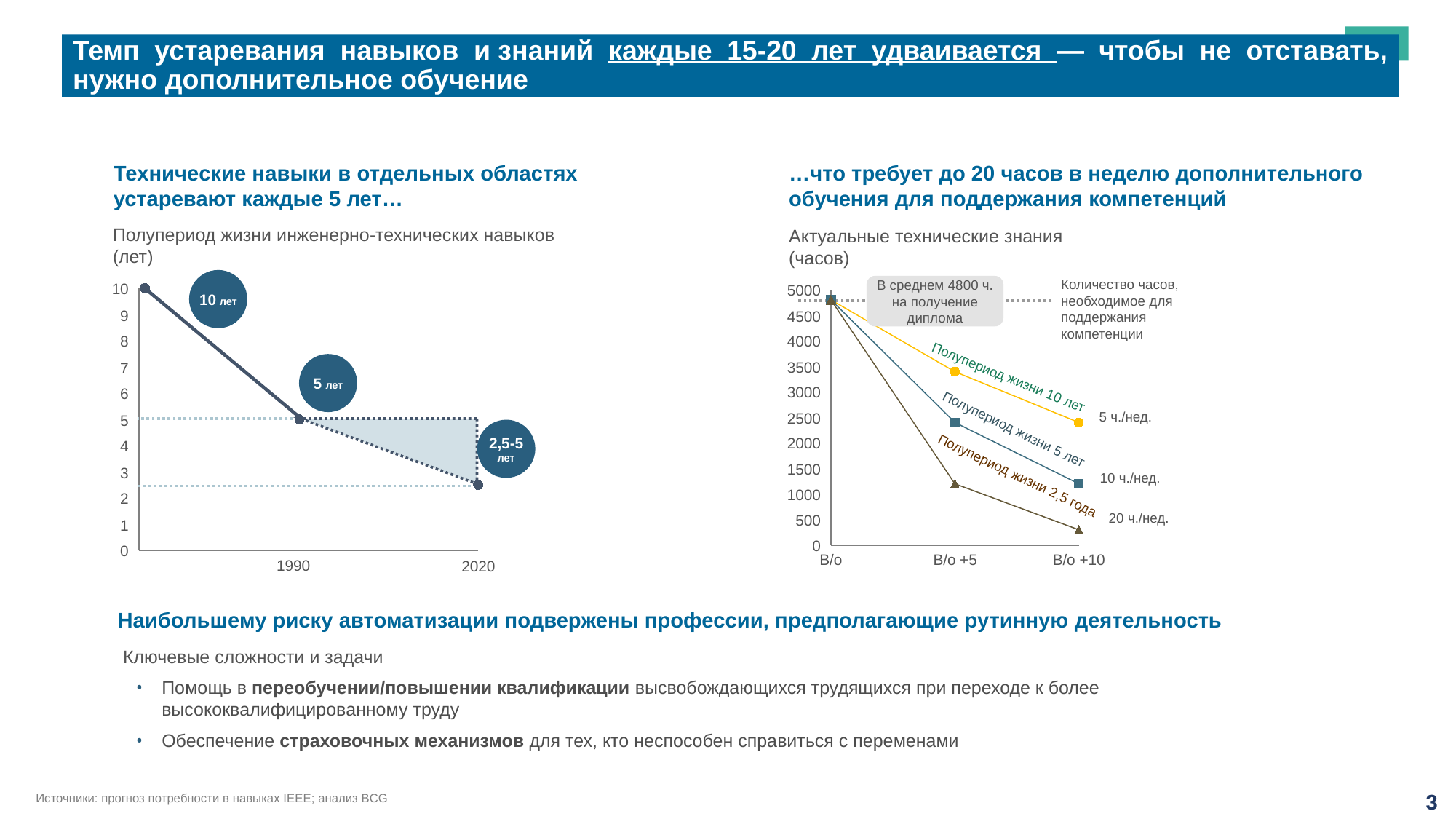
On the right chart (Актуальные технические знания), which series has the highest value at В/о +10? Полупериод жизни 10 лет On the left chart (Полупериод жизни инженерно-технических навыков), do the values rise or fall along the x axis? fall On the left chart (Полупериод жизни инженерно-технических навыков), what is the half-life value labelled at 1990? 5 лет On the left chart (Полупериод жизни инженерно-технических навыков), what kind of chart is it? line chart On the right chart (Актуальные технические знания), how many hours per week are labelled for the 'Полупериод жизни 2,5 года' series? 20 ч./нед. On the right chart (Актуальные технические знания), which series has the lowest value at В/о +10? Полупериод жизни 2,5 года On the right chart (Актуальные технические знания), how many categories are on the x axis? 3 On the right chart (Актуальные технические знания), how many series (half-life lines) are plotted? 3 On the left chart (Полупериод жизни инженерно-технических навыков), what is the half-life value labelled at the starting point of the line? 10 лет On the right chart (Актуальные технические знания), what is the average number of hours to obtain a diploma shown at the starting point? 4800 ч. On the left chart (Полупериод жизни инженерно-технических навыков), what is the half-life range labelled at 2020? 2,5-5 лет On the right chart (Актуальные технические знания), is the value of the 'Полупериод жизни 2,5 года' series at В/о +10 greater or less than 500? less